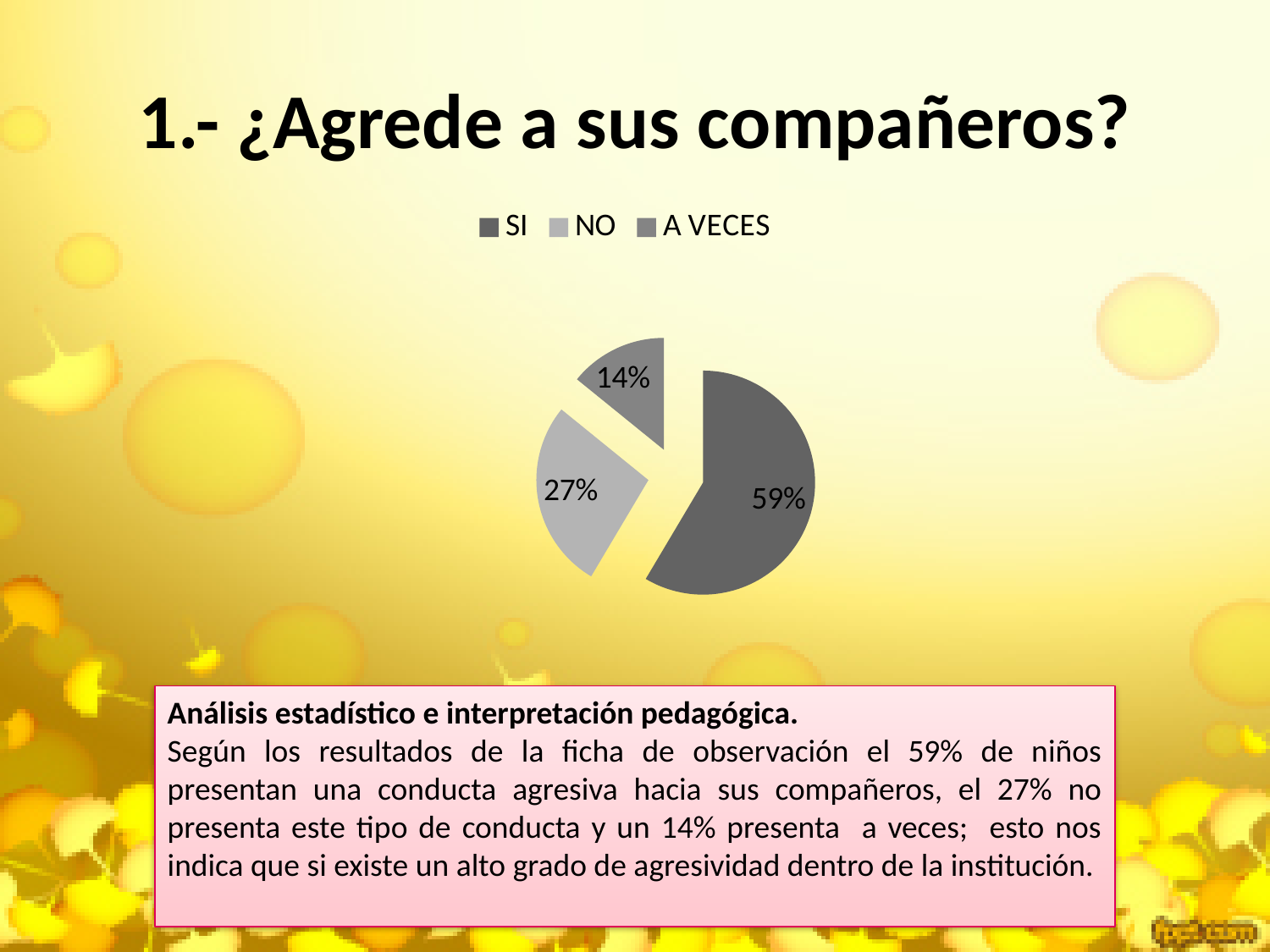
What is the title of the slide containing the chart? 1.- ¿Agrede a sus compañeros? Which slice is larger, NO or A VECES? NO What percentage of the pie corresponds to SI? 59% What percentage of the pie corresponds to NO? 27% Which category has the largest slice of the pie? SI Which category has the smallest slice of the pie? A VECES What is the difference in percentage points between the NO slice and the A VECES slice? 13 What is the difference in percentage points between the SI slice and the NO slice? 32 What kind of chart is shown on the slide? pie chart How many categories does the pie chart show? 3 What percentage of the pie corresponds to A VECES? 14% How many entries does the legend list? 3